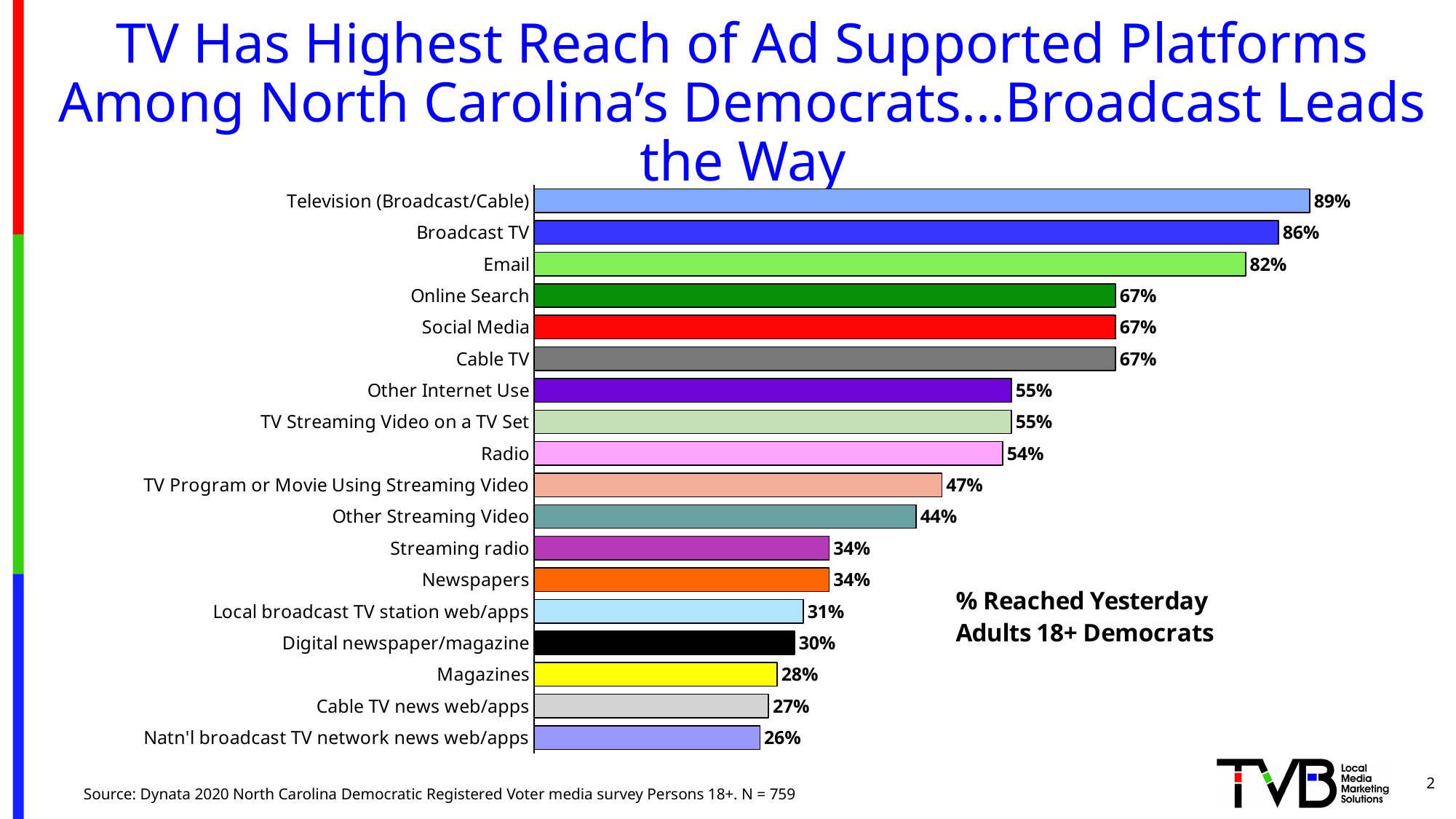
What is the value for Television (Broadcast/Cable)? 89% Which category has the highest value? Television (Broadcast/Cable) What is the value for Magazines? 28% Which category has the lowest value? Natn'l broadcast TV network news web/apps What is the value for Newspapers? 34% What kind of chart is shown on the slide? Bar chart What is the value for Natn'l broadcast TV network news web/apps? 26% What is the difference between the values for Broadcast TV and Cable TV? 19% How many categories are shown in the chart? 18 What is the value for Radio? 54% Which is larger, the value for Other Internet Use or the value for TV Program or Movie Using Streaming Video? Other Internet Use What is the difference between the values for Email and Other Streaming Video? 38%